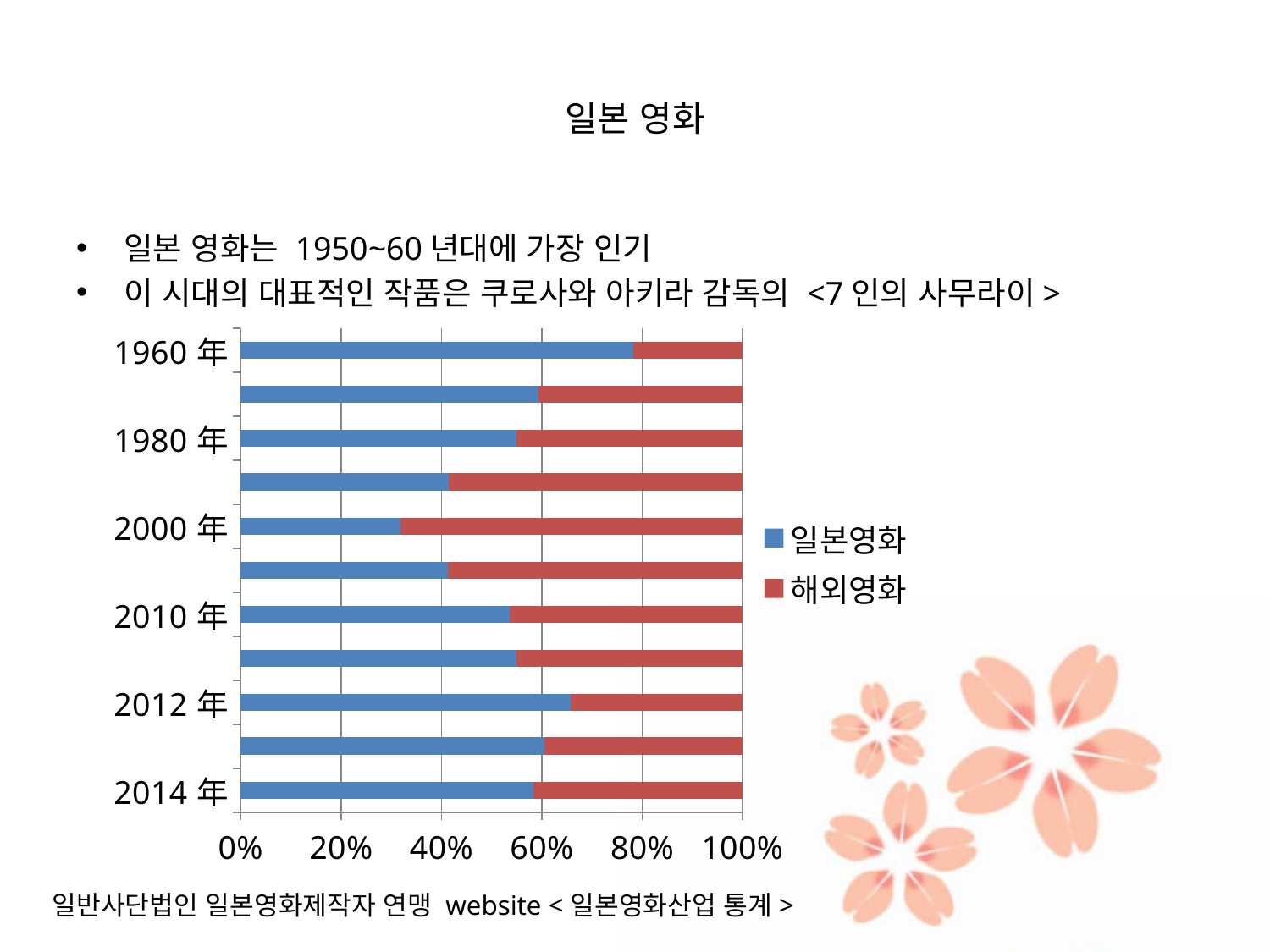
How many bars are plotted in the chart? 11 Does the 일본영화 share rise or fall from 1960年 to 2000年? fall How many series does the legend list? 2 Is the 일본영화 share for 2000年 greater or less than 40%? less Which has the larger 해외영화 share, 2000年 or 1960年? 2000年 Is the 일본영화 share for 2012年 greater or less than 60%? greater What kind of chart is shown on the slide? Stacked bar chart What are the two series named in the legend? 일본영화 and 해외영화 Which has the larger 일본영화 share, 1960年 or 2000年? 1960年 Which labeled year has the lowest share for 일본영화? 2000年 Is the 일본영화 share for 1960年 greater or less than 60%? greater Which labeled year has the highest share for 일본영화? 1960年